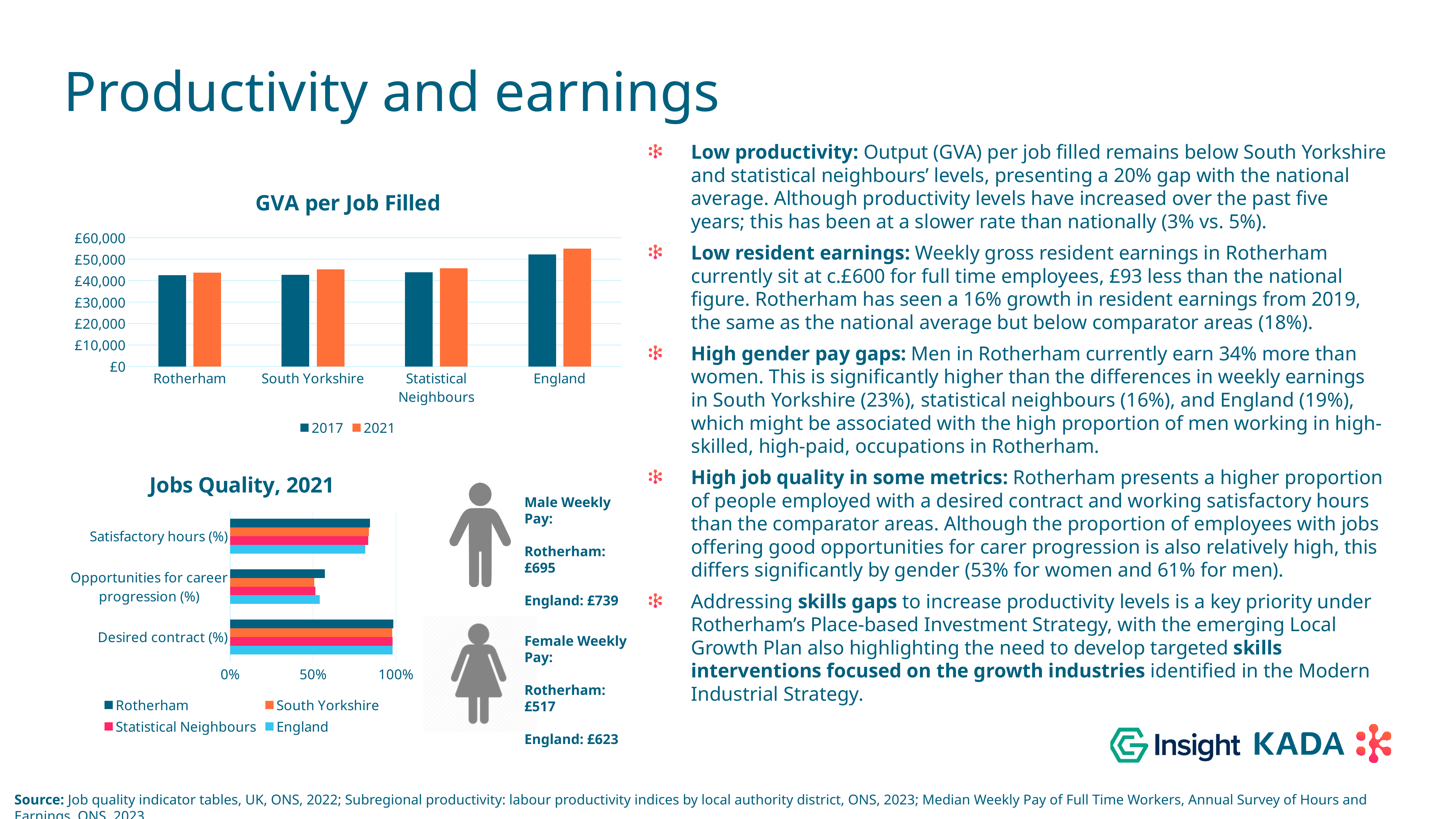
What type of chart is the 'GVA per Job Filled' chart? bar chart In the 'Jobs Quality, 2021' chart, which is larger for 'Opportunities for career progression (%)': Rotherham or South Yorkshire? Rotherham In the 'GVA per Job Filled' chart, is the 2017 value for Rotherham greater or less than £50,000? less In the 'GVA per Job Filled' chart, is the 2021 value for England greater or less than £50,000? greater In the 'GVA per Job Filled' chart, what are the two years shown in the legend? 2017 and 2021 In the 'GVA per Job Filled' chart, is the 2021 value for England larger than the 2021 value for Rotherham? Yes In the 'Jobs Quality, 2021' chart, is the Rotherham value for 'Opportunities for career progression (%)' greater or less than 50%? greater In the 'GVA per Job Filled' chart, which category has the highest 2021 value? England How many categories are shown on the 'Jobs Quality, 2021' chart? 3 How many categories are shown on the x axis of the 'GVA per Job Filled' chart? 4 How many series does the legend of the 'Jobs Quality, 2021' chart list? 4 How many series does the legend of the 'GVA per Job Filled' chart list? 2